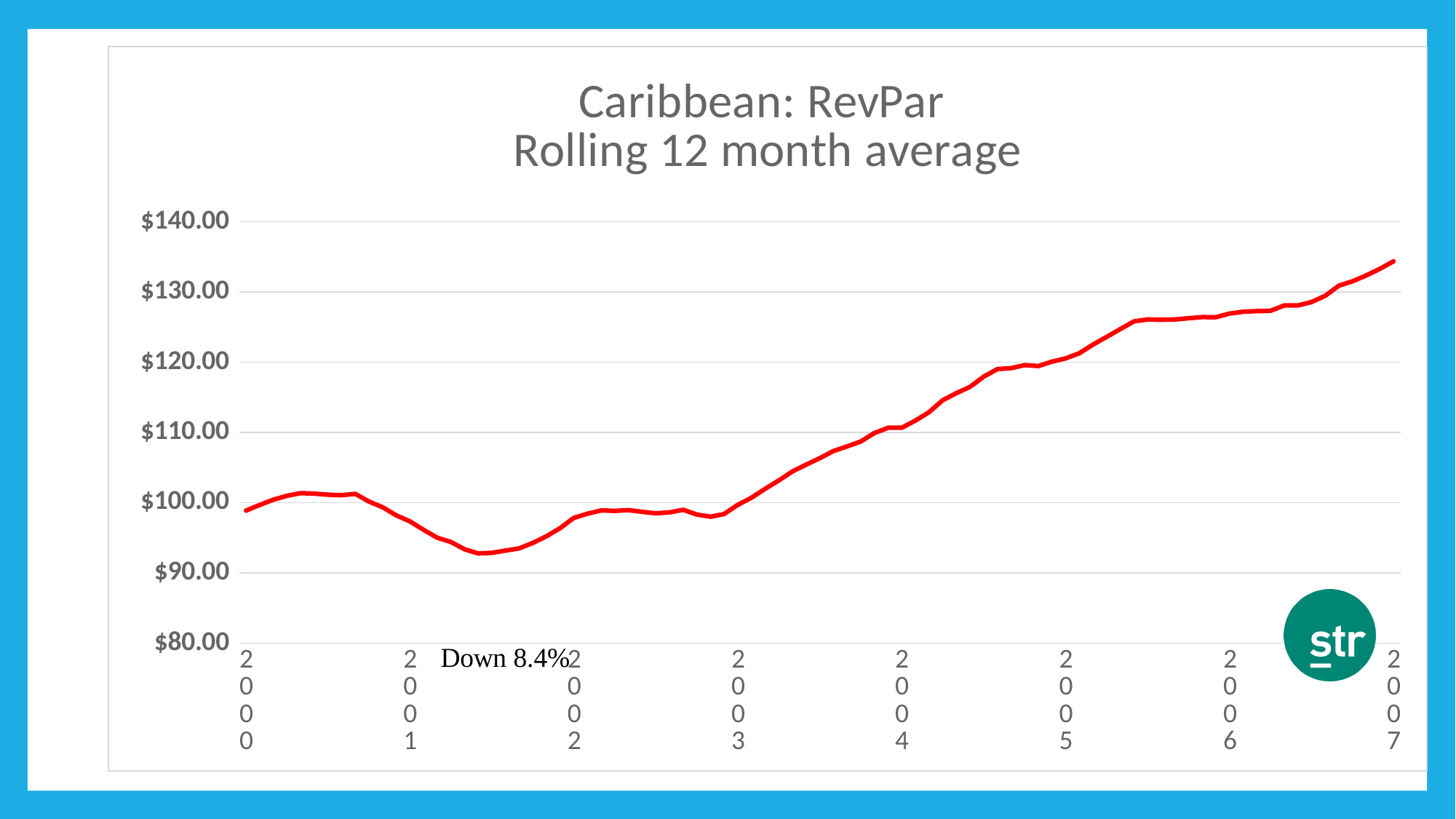
Is the value at 2001 greater or less than $100.00? less Which year label has the higher value, 2002 or 2005? 2005 What text annotation is printed near the x axis between 2001 and 2002? Down 8.4% Which year label has the higher value, 2007 or 2000? 2007 Is the value at 2006 greater or less than $120.00? greater Does the line generally rise or fall from 2003 to 2007? rise Is the lowest point of the line greater or less than $90.00? greater What is the title of the chart? Caribbean: RevPar Rolling 12 month average What kind of chart is shown on the slide? line chart How many year labels are shown on the x axis? 8